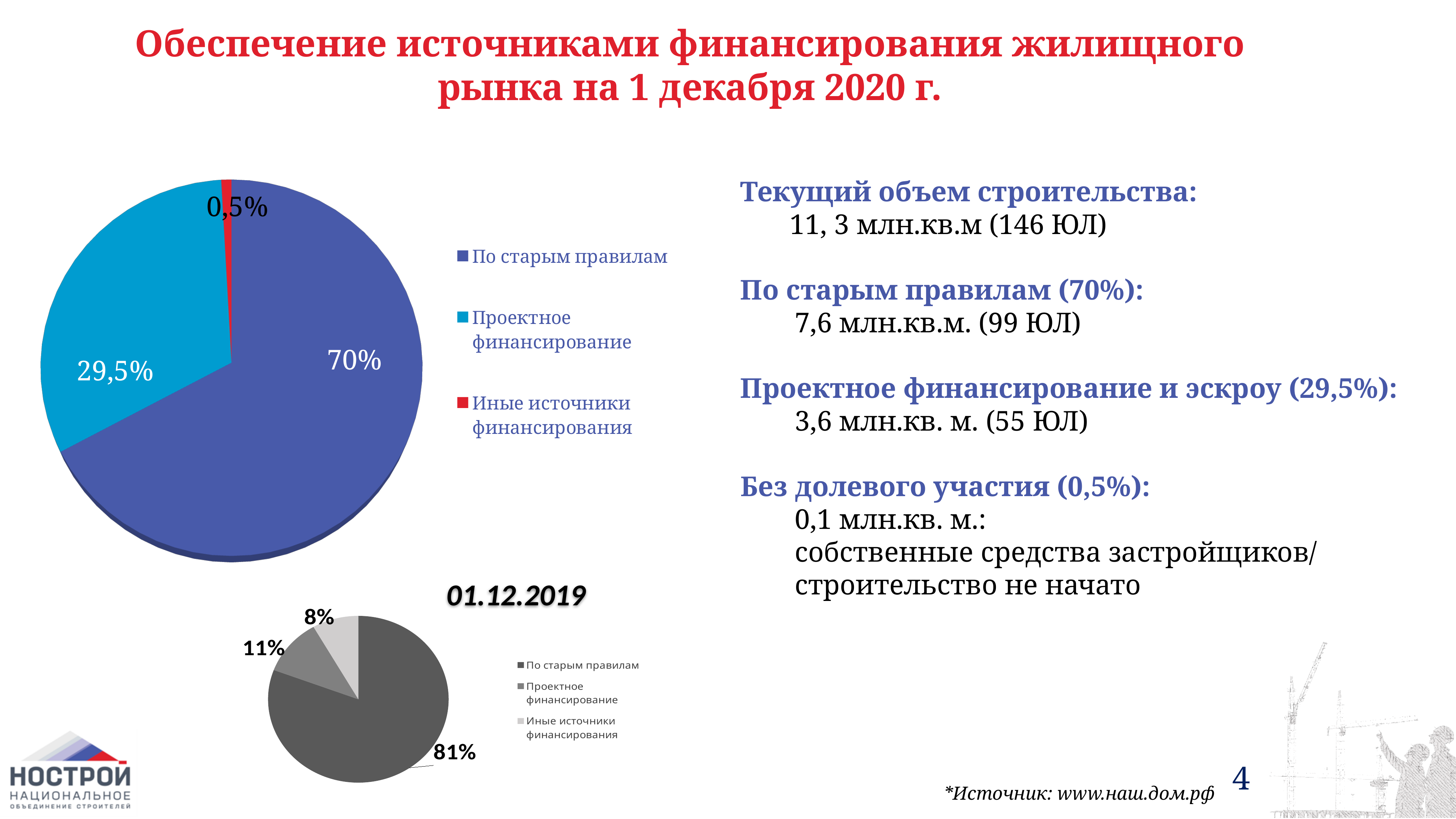
In the large pie chart on the left, what is the difference between the shares of "По старым правилам" and "Проектное финансирование"? 40,5% In the large pie chart on the left, what share is labelled for "Иные источники финансирования"? 0,5% In the large pie chart on the left, which category has the smallest slice? Иные источники финансирования In the small pie chart labelled 01.12.2019, what share is labelled for "Иные источники финансирования"? 8% In the large pie chart on the left, what share is labelled for "Проектное финансирование"? 29,5% In the large pie chart on the left, which category has the largest slice? По старым правилам How many slices does the large pie chart on the left have? 3 In the large pie chart on the left, what share is labelled for "По старым правилам"? 70% What type of chart is the large chart on the left of the slide? Pie chart In the small pie chart labelled 01.12.2019, what share is labelled for "По старым правилам"? 81% In the small pie chart labelled 01.12.2019, what share is labelled for "Проектное финансирование"? 11% In the small pie chart labelled 01.12.2019, which category has the smallest slice? Иные источники финансирования